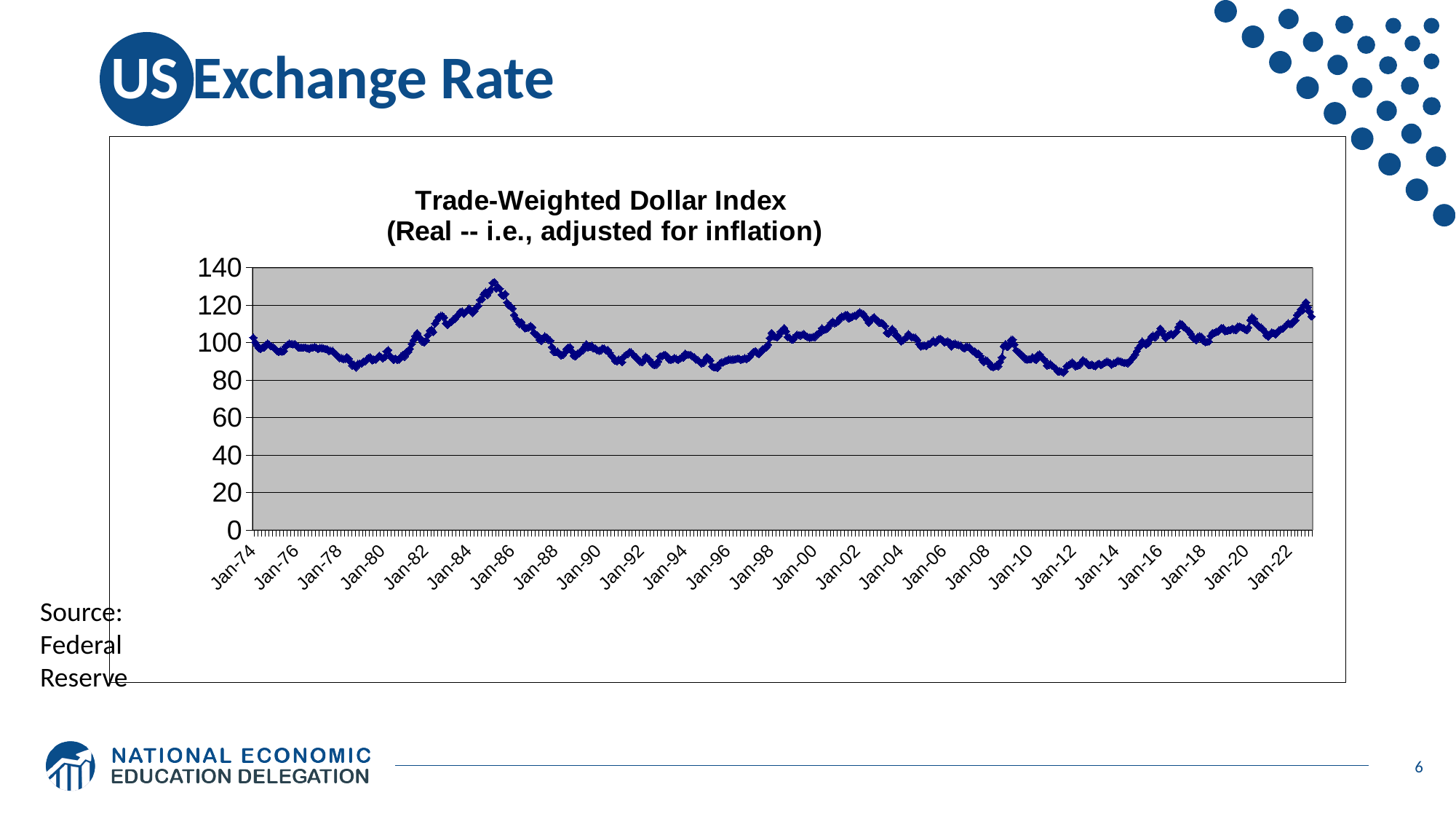
Does the index rise or fall between Jan-02 and Jan-08? Fall What is the title of the chart? Trade-Weighted Dollar Index (Real -- i.e., adjusted for inflation) Is the value of the index around Jan-22 greater or less than 100? greater Which is higher: the index peak around Jan-86 or the peak around Jan-02? Jan-86 Is the value of the index around Jan-02 greater or less than 100? greater What is the highest value shown on the y axis of the chart? 140 What kind of chart is shown on the slide? Line chart Is the value of the index around Jan-78 greater or less than 100? less Around which x-axis label does the Trade-Weighted Dollar Index reach its highest point? Jan-86 Does the index rise or fall between Jan-80 and Jan-86? Rise